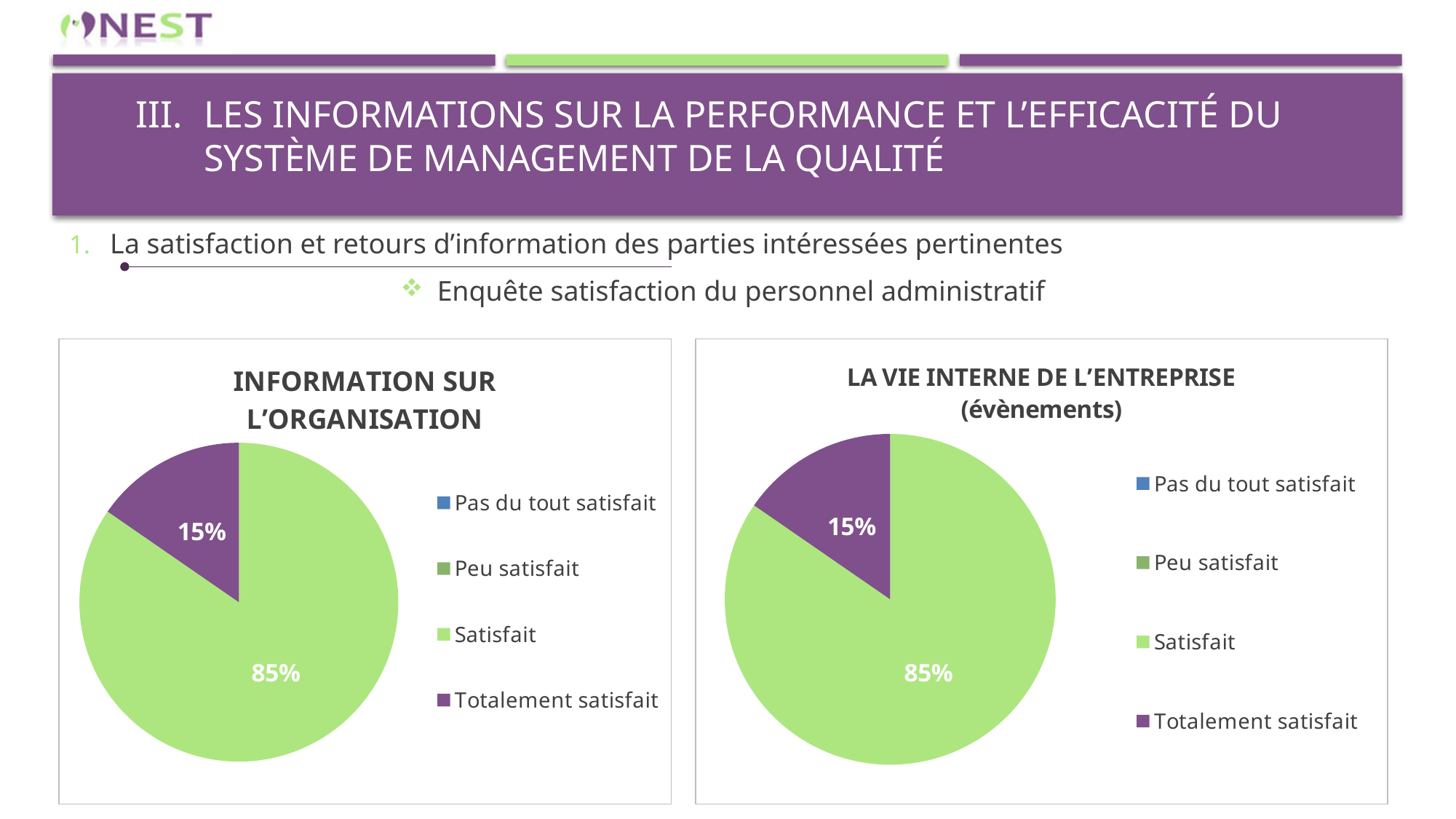
In the 'INFORMATION SUR L'ORGANISATION' chart, what share of the pie is 'Satisfait'? 85% What type of chart is the 'INFORMATION SUR L'ORGANISATION' chart? Pie chart How many entries does the legend of the 'LA VIE INTERNE DE L'ENTREPRISE (évènements)' chart list? 4 In the 'INFORMATION SUR L'ORGANISATION' chart, which category has the largest slice? Satisfait In the 'LA VIE INTERNE DE L'ENTREPRISE (évènements)' chart, what share of the pie is 'Satisfait'? 85% In the 'LA VIE INTERNE DE L'ENTREPRISE (évènements)' chart, what share of the pie is 'Totalement satisfait'? 15% In the 'LA VIE INTERNE DE L'ENTREPRISE (évènements)' chart, which is larger, 'Satisfait' or 'Totalement satisfait'? Satisfait In the 'LA VIE INTERNE DE L'ENTREPRISE (évènements)' chart, which category has the largest slice? Satisfait What is the title of the chart on the right side of the slide? LA VIE INTERNE DE L'ENTREPRISE (évènements) In the 'INFORMATION SUR L'ORGANISATION' chart, what is the difference between the 'Satisfait' and 'Totalement satisfait' shares? 70% In the 'INFORMATION SUR L'ORGANISATION' chart, what colour is the 'Totalement satisfait' slice? Purple